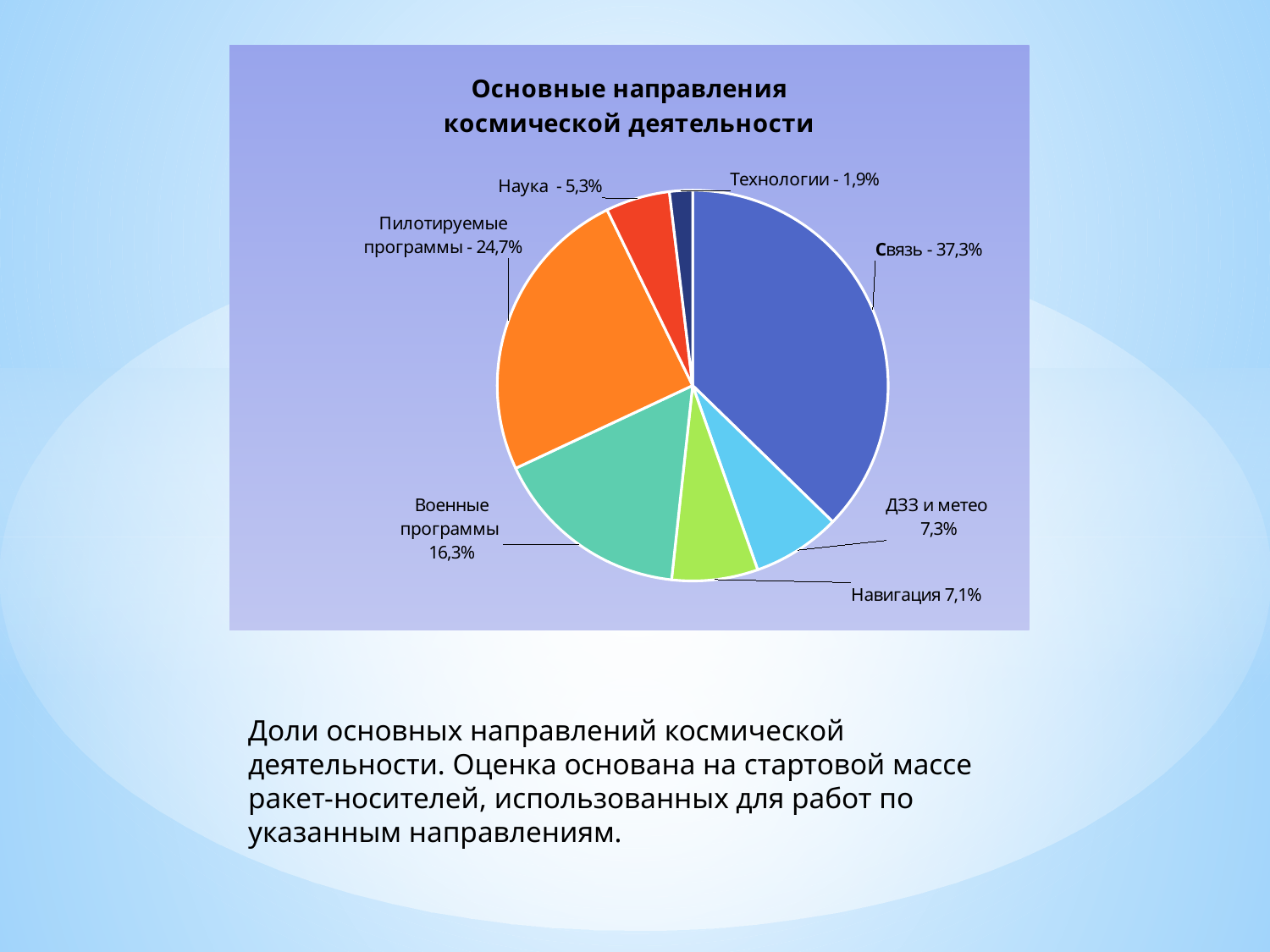
How many slices does the pie chart have? 7 What share of the pie does Связь have? 37,3% What is the value shown for Пилотируемые программы? 24,7% Which category has the smallest slice of the pie? Технологии What kind of chart is shown on the slide? Pie chart Which category has the largest slice of the pie? Связь What is the value shown for Наука? 5,3% Which is larger, the share of Военные программы or the share of ДЗЗ и метео? Военные программы What is the difference between the shares of Связь and Пилотируемые программы? 12,6% What is the value shown for Военные программы? 16,3% What is the difference between the shares of ДЗЗ и метео and Навигация? 0,2% What is the title of the chart? Основные направления космической деятельности